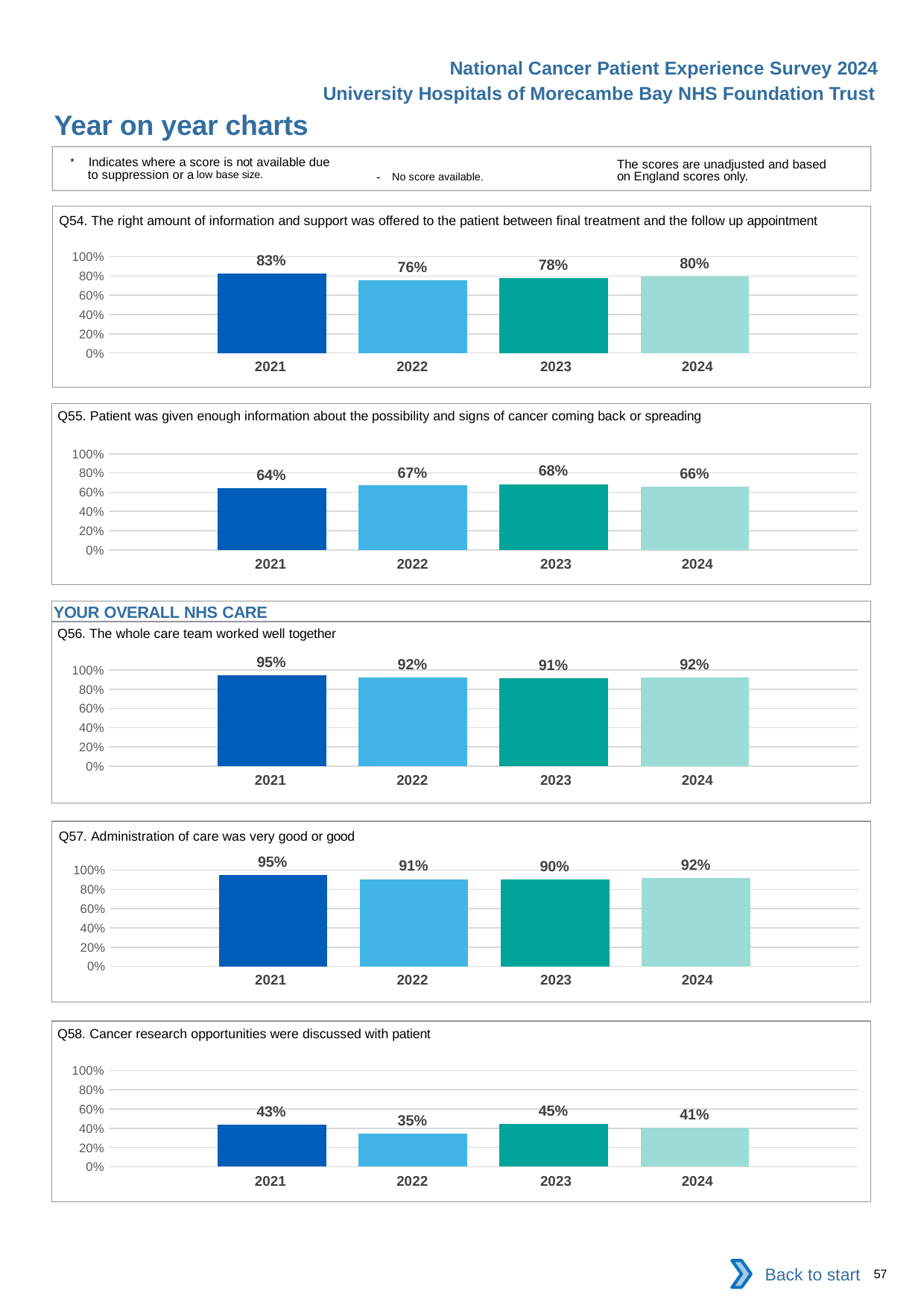
How many years are shown in the Q58 chart? 4 In the Q56 chart, what is the value for 2023? 91% In the Q56 chart, which year has the highest value? 2021 In the Q55 chart, which year has the highest value? 2023 In the Q54 chart, what is the value for 2021? 83% In the Q55 chart, what is the value for 2024? 66% In the Q57 chart, what is the difference between the 2021 and 2024 values? 3% In the Q54 chart, which year has the lowest value? 2022 In the Q55 chart, what is the difference between the 2023 and 2021 values? 4% In the Q58 chart, which year has the lowest value? 2022 In the Q58 chart, is the value for 2023 larger or smaller than the value for 2024? larger What type of chart is the Q57 chart? bar chart